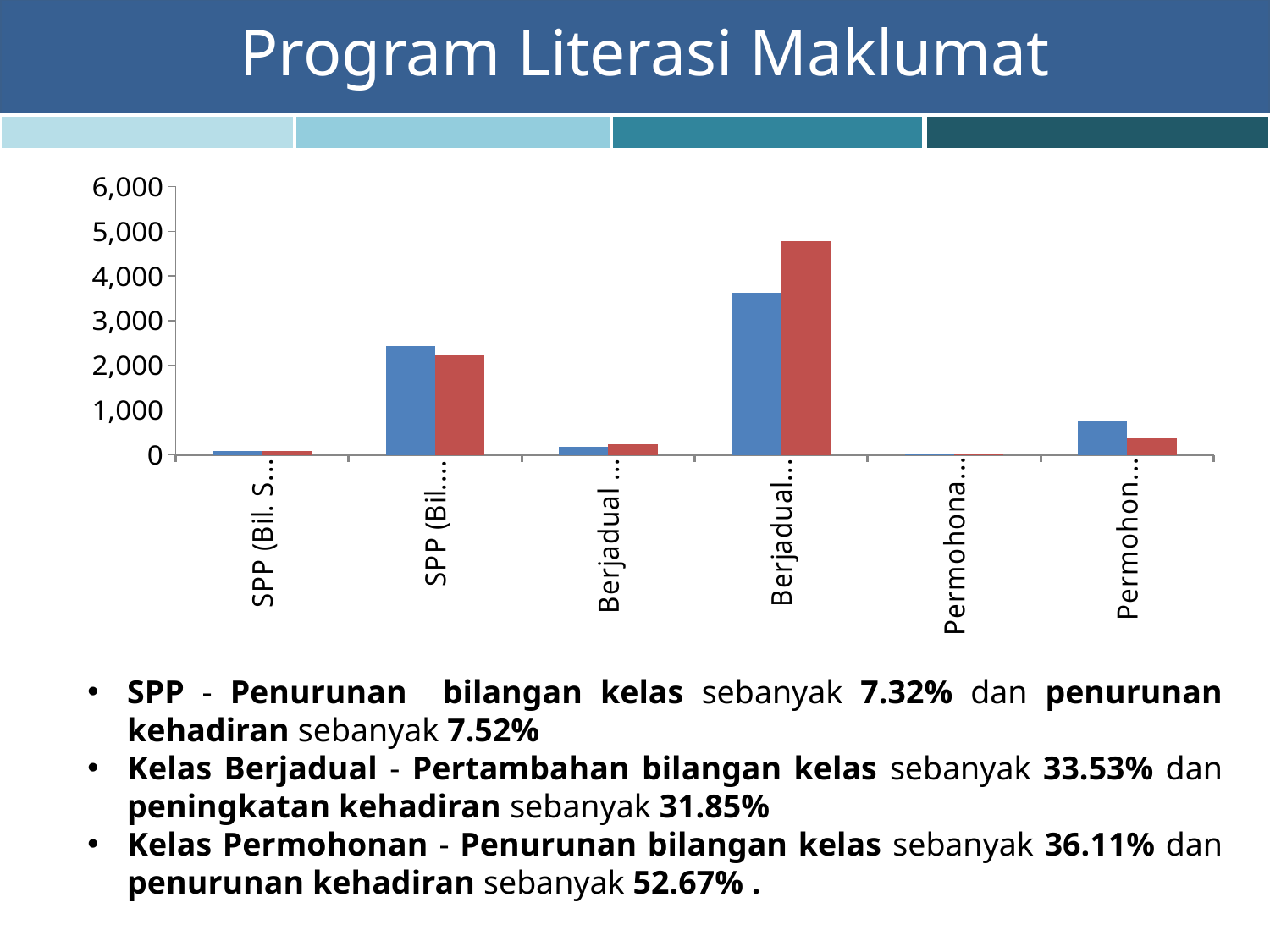
What is the highest value shown on the vertical axis of the chart? 6,000 How many categories are shown along the x axis of the chart? 6 Which category has the tallest bar in the chart? The fourth category from the left (Berjadual...) Is the value of the red bar in the fourth category from the left greater or less than 4,000? greater How many bars are plotted for each category in the chart? 2 Is the value of the blue bar in the sixth category from the left greater or less than 1,000? less Is the value of the blue bar in the fourth category from the left greater or less than 3,000? greater What kind of chart is shown on the slide? Bar chart What two colours are used for the bars in the chart? Blue and red In the fourth category from the left, which bar is taller, the blue one or the red one? The red one In the sixth category from the left, which bar is taller, the blue one or the red one? The blue one